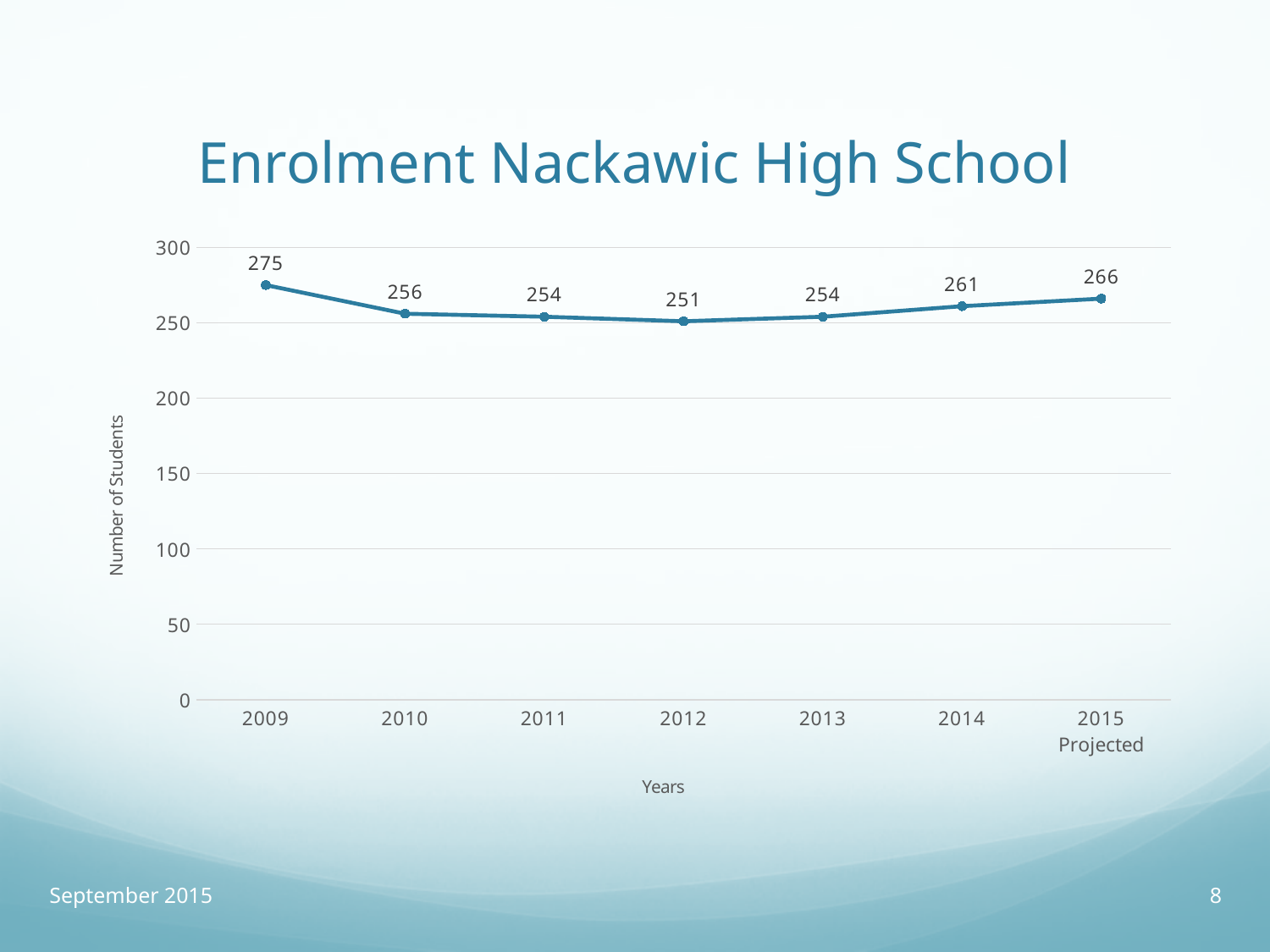
What was the enrolment at Nackawic High School in 2009? 275 What kind of chart is shown on the slide? line chart What is the difference in enrolment between 2009 and 2012? 24 By how much is the 2015 projected enrolment higher than the 2014 enrolment? 5 How many years are plotted on the chart? 7 What is the label on the vertical axis of the chart? Number of Students Is the enrolment for 2013 greater or less than 300? less What was the enrolment in 2012? 251 Which year had higher enrolment, 2010 or 2014? 2014 Which year has the lowest enrolment? 2012 Which year has the highest enrolment? 2009 What is the projected enrolment for 2015? 266